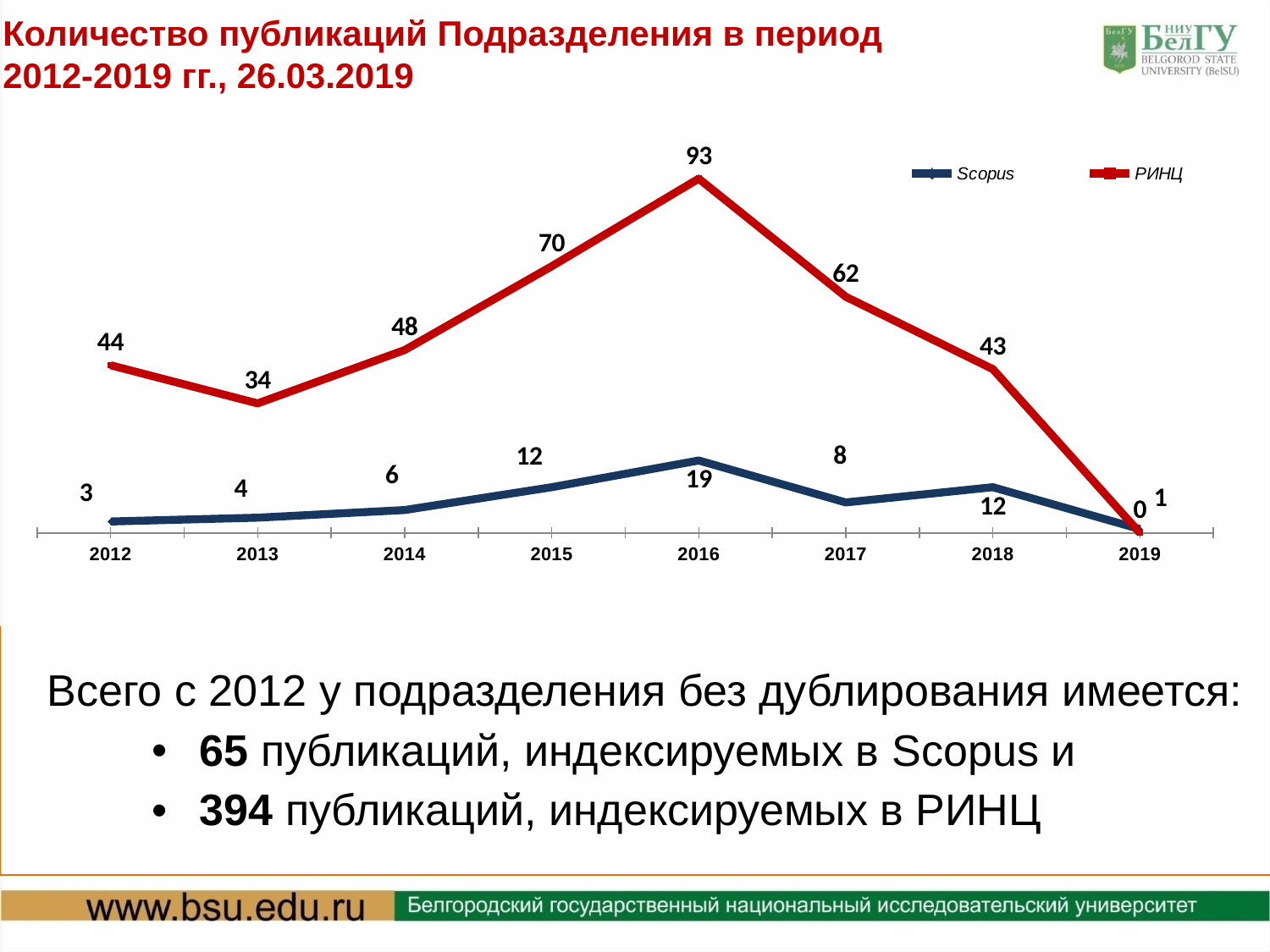
What is the Scopus value for 2014? 6 Does the РИНЦ series rise or fall from 2016 to 2018? fall How many years are plotted on the x axis? 8 How many series does the legend list? 2 In which year is the РИНЦ series highest? 2016 Which year has the larger Scopus value, 2015 or 2017? 2015 What is the Scopus value for 2016? 19 What is the РИНЦ value for 2016? 93 What is the difference between the РИНЦ values for 2016 and 2015? 23 What is the РИНЦ value for 2012? 44 What are the two series named in the legend? Scopus and РИНЦ What kind of chart is shown on the slide? line chart